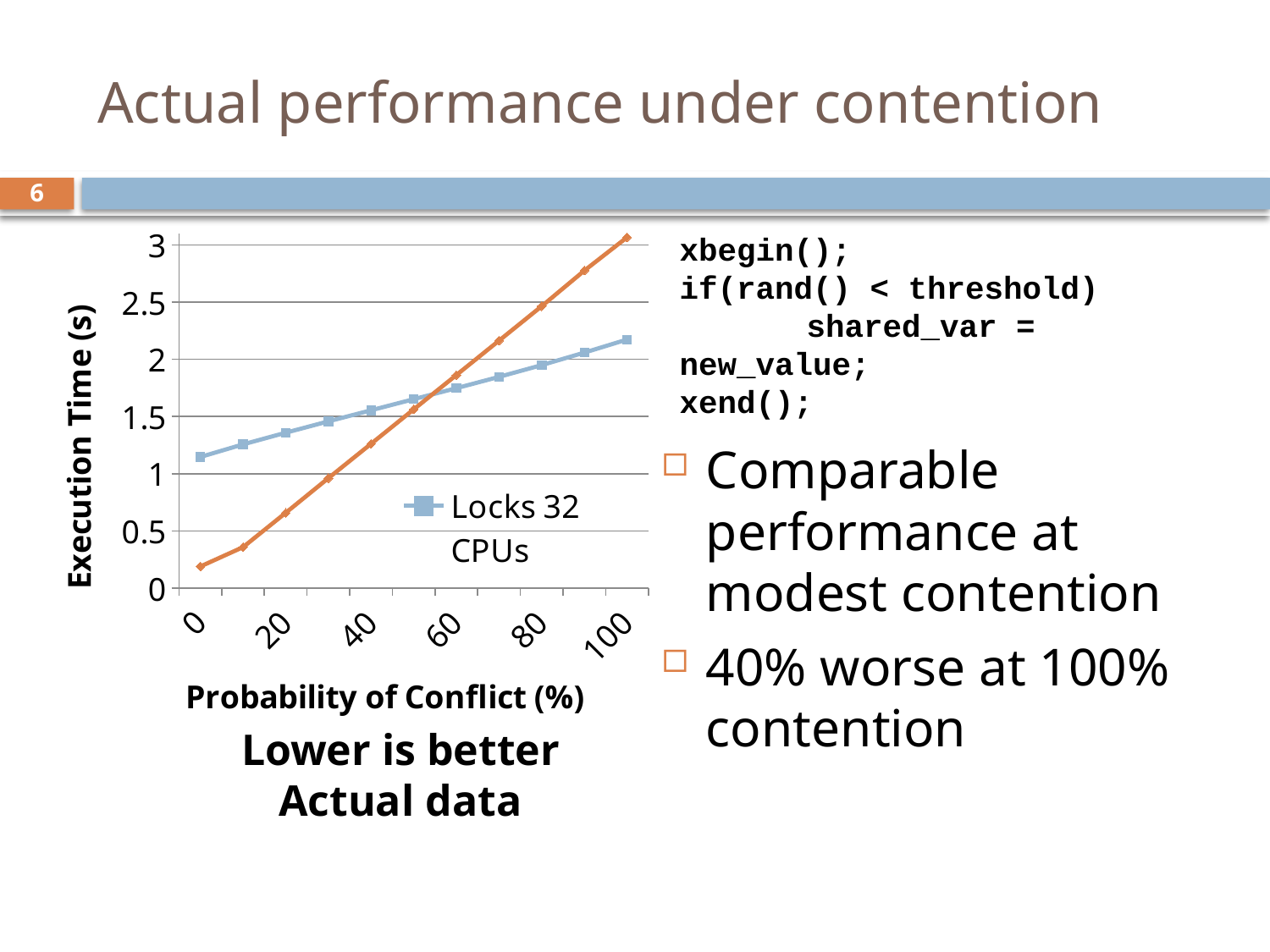
Is the execution time for Locks 32 CPUs at 0% probability of conflict greater or less than 1? greater Does the execution time for Locks 32 CPUs rise or fall as the probability of conflict increases? rise Does the orange line rise or fall as the probability of conflict increases from 0 to 100? rise What is the title of the chart's y axis? Execution Time (s) What kind of chart is shown on the slide? line chart How many lines are plotted on the chart? 2 How many series does the chart's legend list? 1 At 100% probability of conflict, which line has the higher execution time, the orange line or Locks 32 CPUs? the orange line How many data points does the Locks 32 CPUs line have? 11 Is the execution time of the orange line at 0% probability of conflict greater or less than 0.5? less Is the execution time for Locks 32 CPUs at 100% probability of conflict greater or less than 2? greater